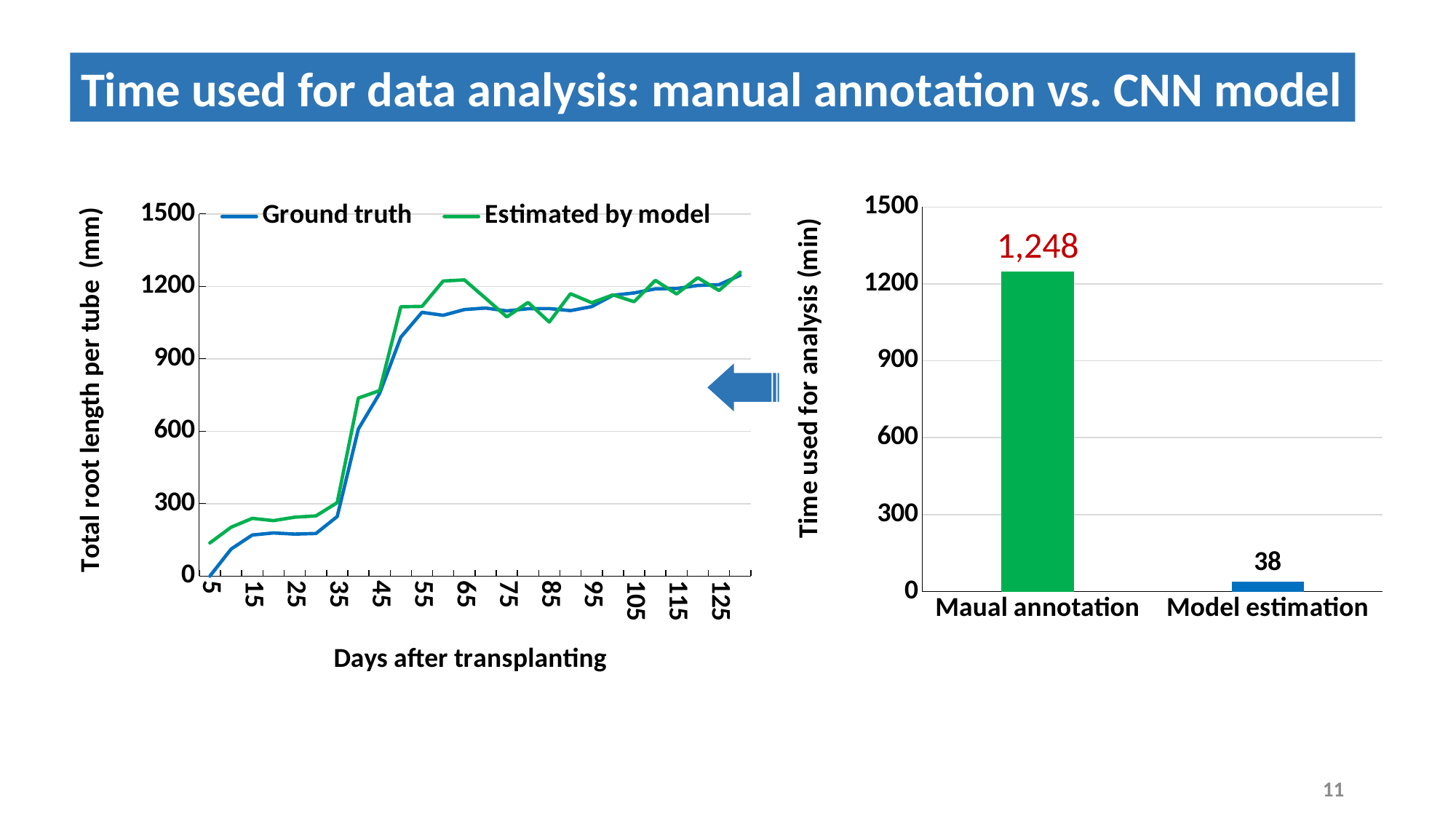
What kind of chart is the chart on the right? Bar chart In the bar chart on the right, what is the time used for analysis for Model estimation? 38 In the line chart on the left, does the Ground truth line rise or fall between day 5 and day 55? Rise In the bar chart on the right, which category has the lowest time used for analysis? Model estimation In the line chart on the left, is the Estimated by model value at day 15 greater or less than 300? less In the bar chart on the right, which category has the higher time used for analysis? Maual annotation In the bar chart on the right, how many categories are shown on the x axis? 2 In the line chart on the left, is the Ground truth value at day 65 greater or less than 900? greater In the line chart on the left, how many series does the legend list? 2 In the bar chart on the right, what is the time used for analysis for Maual annotation? 1,248 In the bar chart on the right, what is the difference in time used between Maual annotation and Model estimation? 1,210 What kind of chart is the chart on the left? Line chart